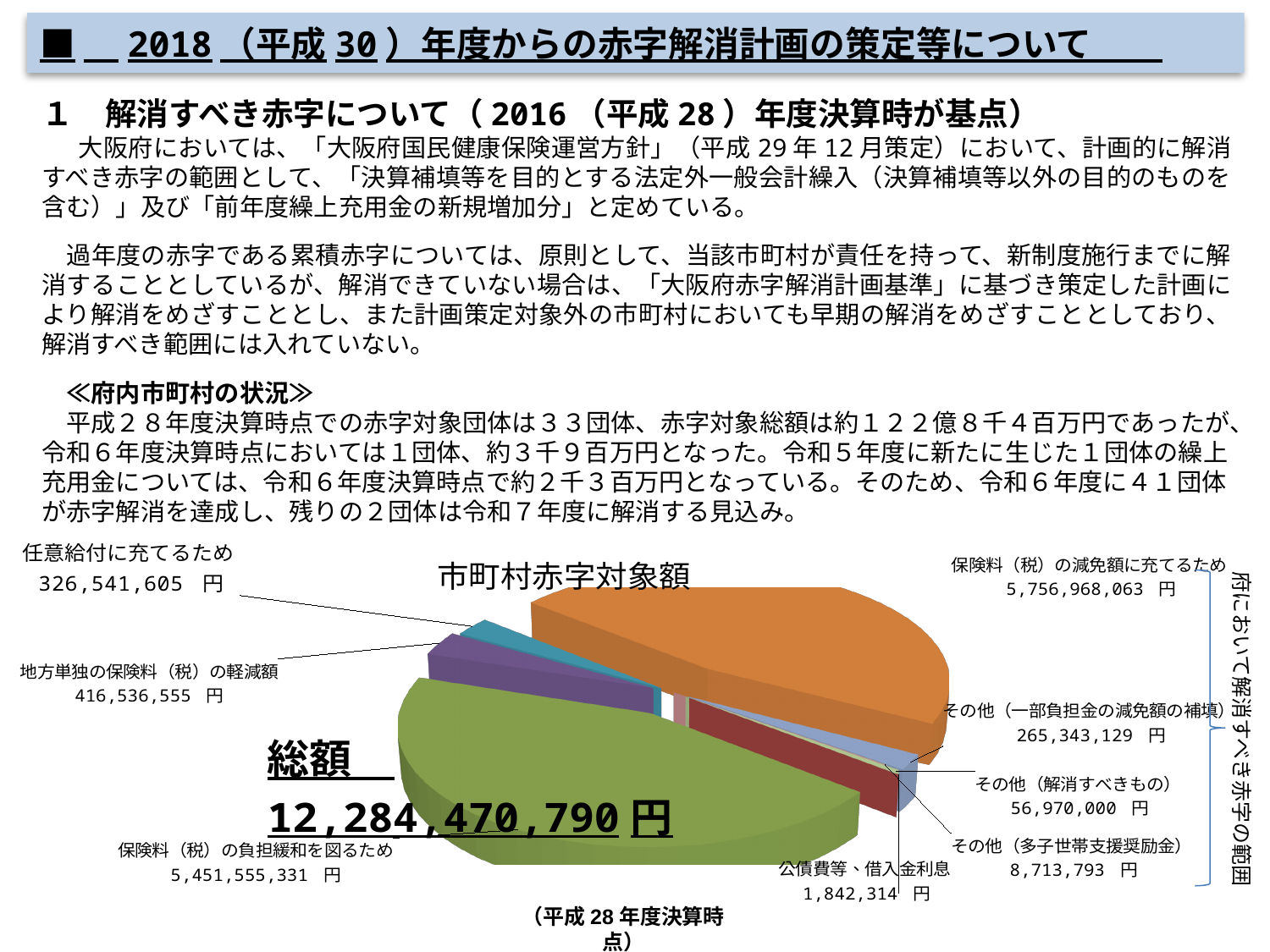
Which category has the largest value in the pie chart? 保険料（税）の減免額に充てるため What is the value for その他（解消すべきもの） in the pie chart? 56,970,000 円 What is the title of the pie chart? 市町村赤字対象額 What is the difference between 地方単独の保険料（税）の軽減額 and 任意給付に充てるため in the pie chart? 89,994,950 円 What is the total amount (総額) shown for the pie chart? 12,284,470,790 円 What is the value for 任意給付に充てるため in the pie chart? 326,541,605 円 How many categories are shown in the pie chart? 8 What is the value for 保険料（税）の負担緩和を図るため in the pie chart? 5,451,555,331 円 Which category has the smallest value in the pie chart? 公債費等、借入金利息 What is the value for 地方単独の保険料（税）の軽減額 in the pie chart? 416,536,555 円 What kind of chart is shown on the slide? Pie chart What is the value for 保険料（税）の減免額に充てるため in the pie chart? 5,756,968,063 円